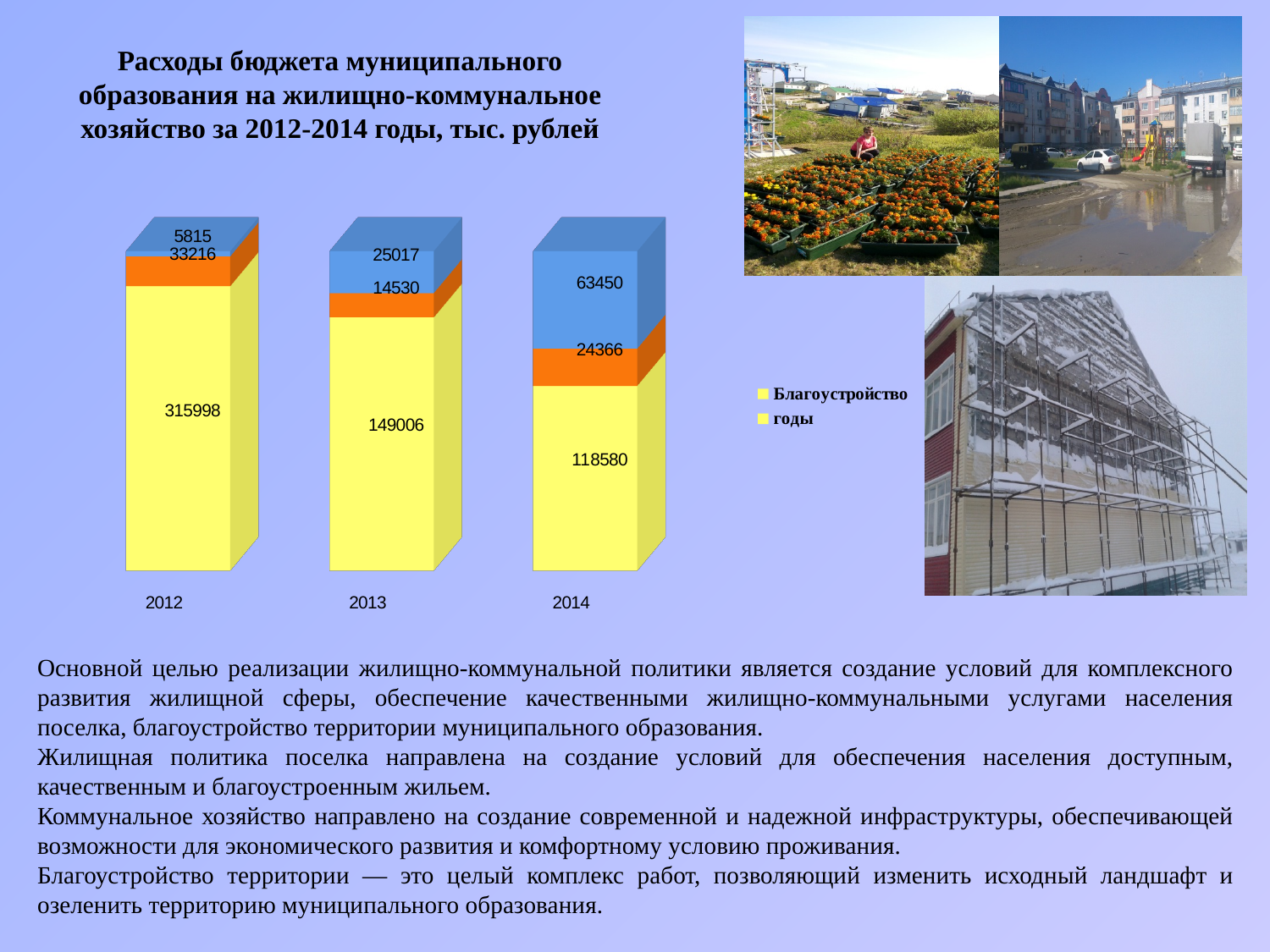
What is the value of the bottom (yellow) segment of the 2012 bar? 315998 Which year has the largest bottom (yellow) segment? 2012 Does the bottom (yellow) segment rise or fall from 2012 to 2014? fall Which year has the smallest top (blue) segment? 2012 What is the value of the top (blue) segment of the 2014 bar? 63450 What is the difference between the bottom (yellow) segment values for 2012 and 2013? 166992 Which is larger: the top (blue) segment for 2013 or for 2014? 2014 What is the value of the middle (orange) segment of the 2013 bar? 14530 What is the total of the stacked bar for 2012? 355029 What is the total of the stacked bar for 2014? 206396 How many years are shown on the x axis of the chart? 3 What is the value of the top (blue) segment of the 2012 bar? 5815